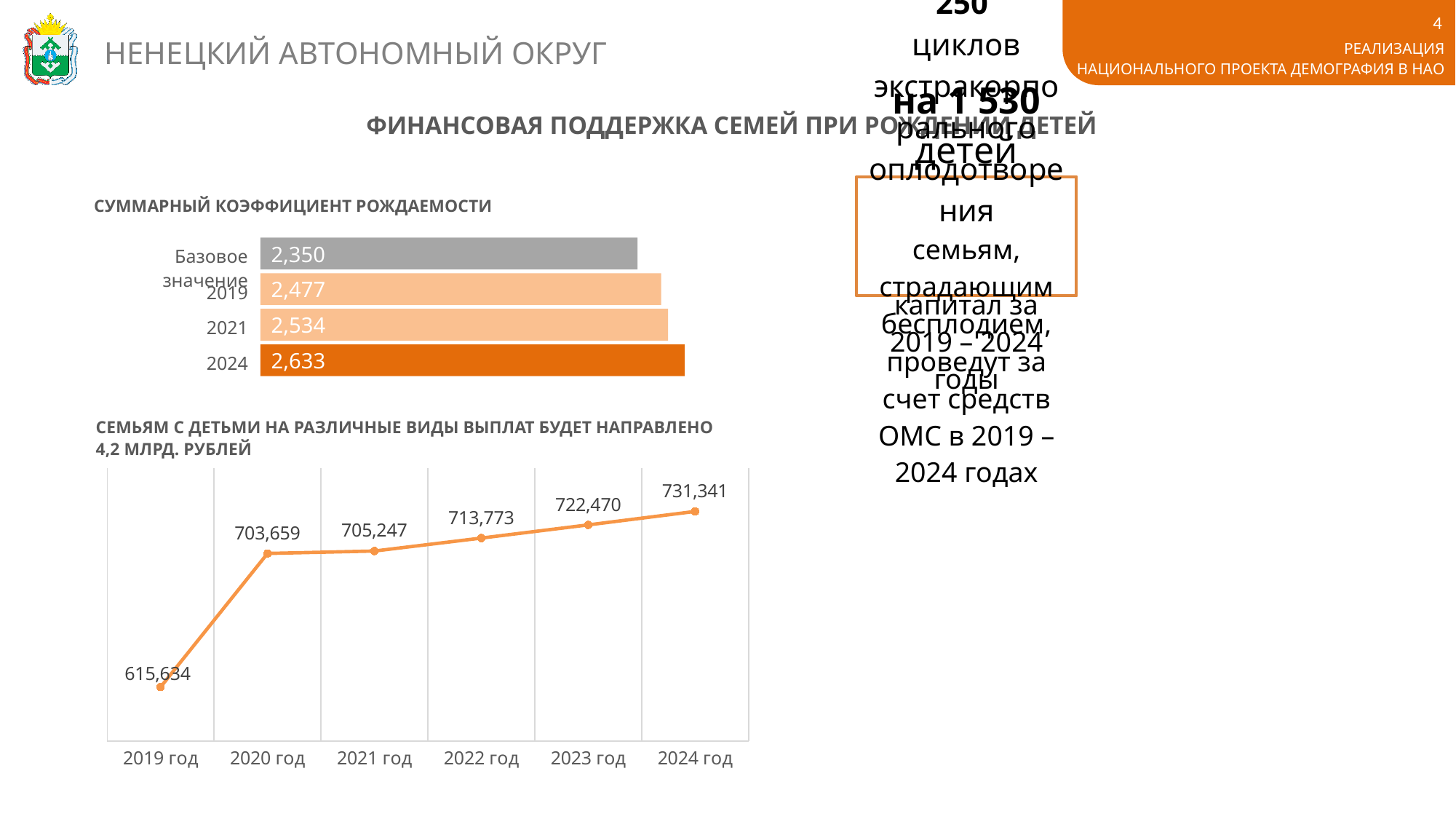
In the line chart 'СЕМЬЯМ С ДЕТЬМИ НА РАЗЛИЧНЫЕ ВИДЫ ВЫПЛАТ БУДЕТ НАПРАВЛЕНО 4,2 МЛРД. РУБЛЕЙ', how many years are plotted? 6 In the line chart 'СЕМЬЯМ С ДЕТЬМИ НА РАЗЛИЧНЫЕ ВИДЫ ВЫПЛАТ БУДЕТ НАПРАВЛЕНО 4,2 МЛРД. РУБЛЕЙ', which year has the highest value? 2024 год In the bar chart 'СУММАРНЫЙ КОЭФФИЦИЕНТ РОЖДАЕМОСТИ', what is the difference between the 2024 value and the 2019 value? 0,156 In the bar chart 'СУММАРНЫЙ КОЭФФИЦИЕНТ РОЖДАЕМОСТИ', which category has the lowest value? Базовое значение In the bar chart 'СУММАРНЫЙ КОЭФФИЦИЕНТ РОЖДАЕМОСТИ', what is the value for 2024? 2,633 What type of chart is used for 'СУММАРНЫЙ КОЭФФИЦИЕНТ РОЖДАЕМОСТИ'? bar chart In the line chart 'СЕМЬЯМ С ДЕТЬМИ НА РАЗЛИЧНЫЕ ВИДЫ ВЫПЛАТ БУДЕТ НАПРАВЛЕНО 4,2 МЛРД. РУБЛЕЙ', which year has the lowest value? 2019 год In the line chart 'СЕМЬЯМ С ДЕТЬМИ НА РАЗЛИЧНЫЕ ВИДЫ ВЫПЛАТ БУДЕТ НАПРАВЛЕНО 4,2 МЛРД. РУБЛЕЙ', what is the value for 2022 год? 713,773 In the bar chart 'СУММАРНЫЙ КОЭФФИЦИЕНТ РОЖДАЕМОСТИ', what is the value for 'Базовое значение'? 2,350 In the line chart 'СЕМЬЯМ С ДЕТЬМИ НА РАЗЛИЧНЫЕ ВИДЫ ВЫПЛАТ БУДЕТ НАПРАВЛЕНО 4,2 МЛРД. РУБЛЕЙ', do the values rise or fall from 2019 год to 2024 год? rise In the line chart 'СЕМЬЯМ С ДЕТЬМИ НА РАЗЛИЧНЫЕ ВИДЫ ВЫПЛАТ БУДЕТ НАПРАВЛЕНО 4,2 МЛРД. РУБЛЕЙ', what is the difference between the 2024 год value and the 2019 год value? 115,707 In the bar chart 'СУММАРНЫЙ КОЭФФИЦИЕНТ РОЖДАЕМОСТИ', how many bars are shown? 4